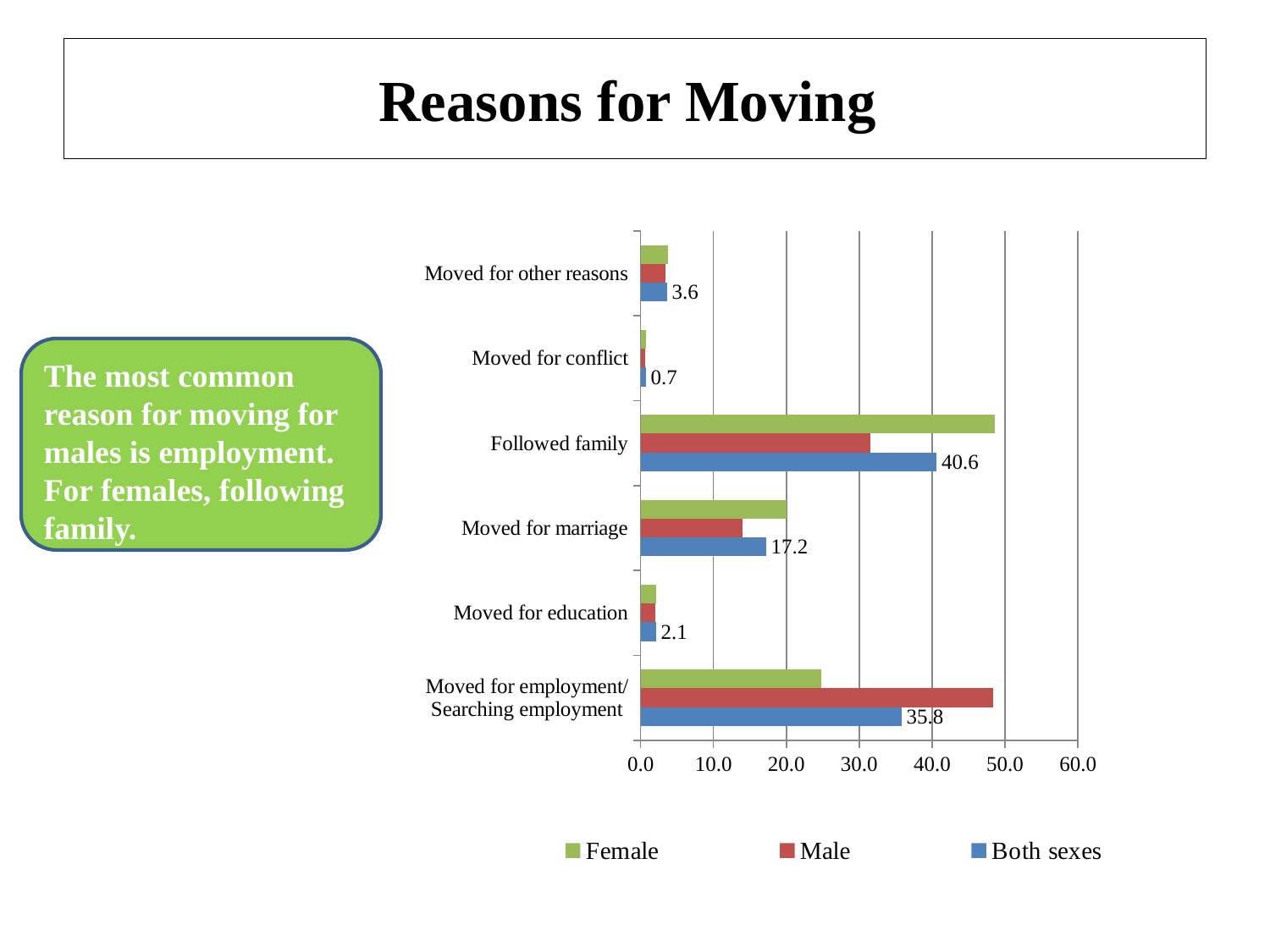
What is the value for Both sexes for Moved for marriage? 17.2 Which category has the lowest value for Both sexes? Moved for conflict Which category has the highest value for Both sexes? Followed family For Followed family, which is larger: the Female value or the Male value? Female How many categories are shown on the chart? 6 What is the value for Both sexes for Moved for employment/Searching employment? 35.8 What is the value for Both sexes for Followed family? 40.6 How many series does the legend list? 3 What kind of chart is shown on the slide? bar chart For Both sexes, what is the difference between Followed family and Moved for employment/Searching employment? 4.8 Is the Female value for Followed family greater or less than 40.0? greater For Moved for employment/Searching employment, which is larger: the Male value or the Female value? Male